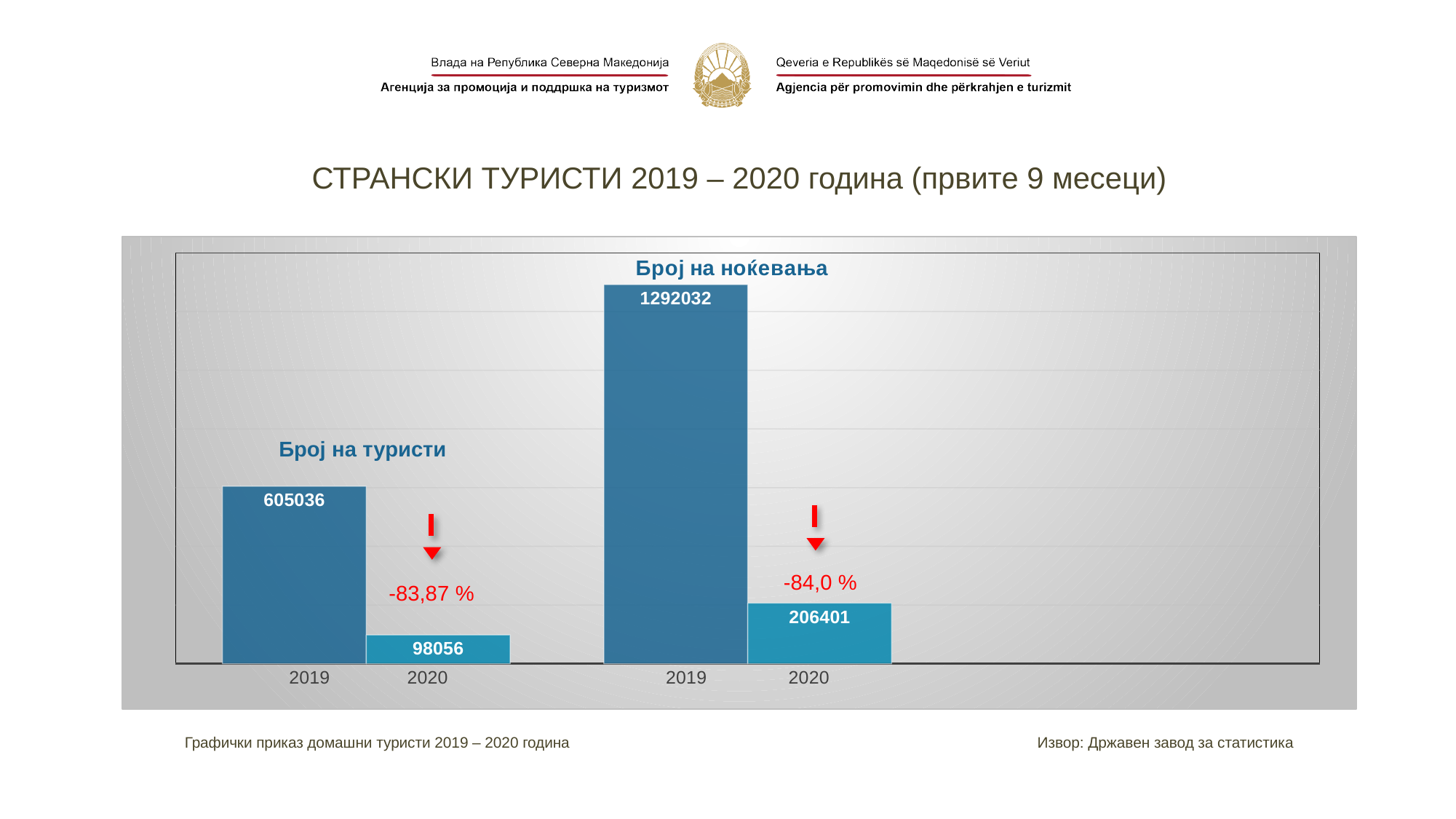
What is the value for 2020 in the "Број на туристи" group? 98056 Which bar has the lowest value on the chart? Број на туристи 2020 What kind of chart is shown on the slide? Bar chart What is the difference between the 2019 and 2020 values for "Број на ноќевања"? 1085631 What is the value for 2019 in the "Број на ноќевања" group? 1292032 What is the value for 2020 in the "Број на ноќевања" group? 206401 What is the difference between the 2019 and 2020 values for "Број на туристи"? 506980 Which is larger: the 2020 value for "Број на туристи" or the 2020 value for "Број на ноќевања"? Број на ноќевања 2020 What is the value for 2019 in the "Број на туристи" group? 605036 Which bar has the highest value on the chart? Број на ноќевања 2019 How many bars are plotted on the chart? 4 What percentage change is shown for "Број на ноќевања" from 2019 to 2020? -84,0 %